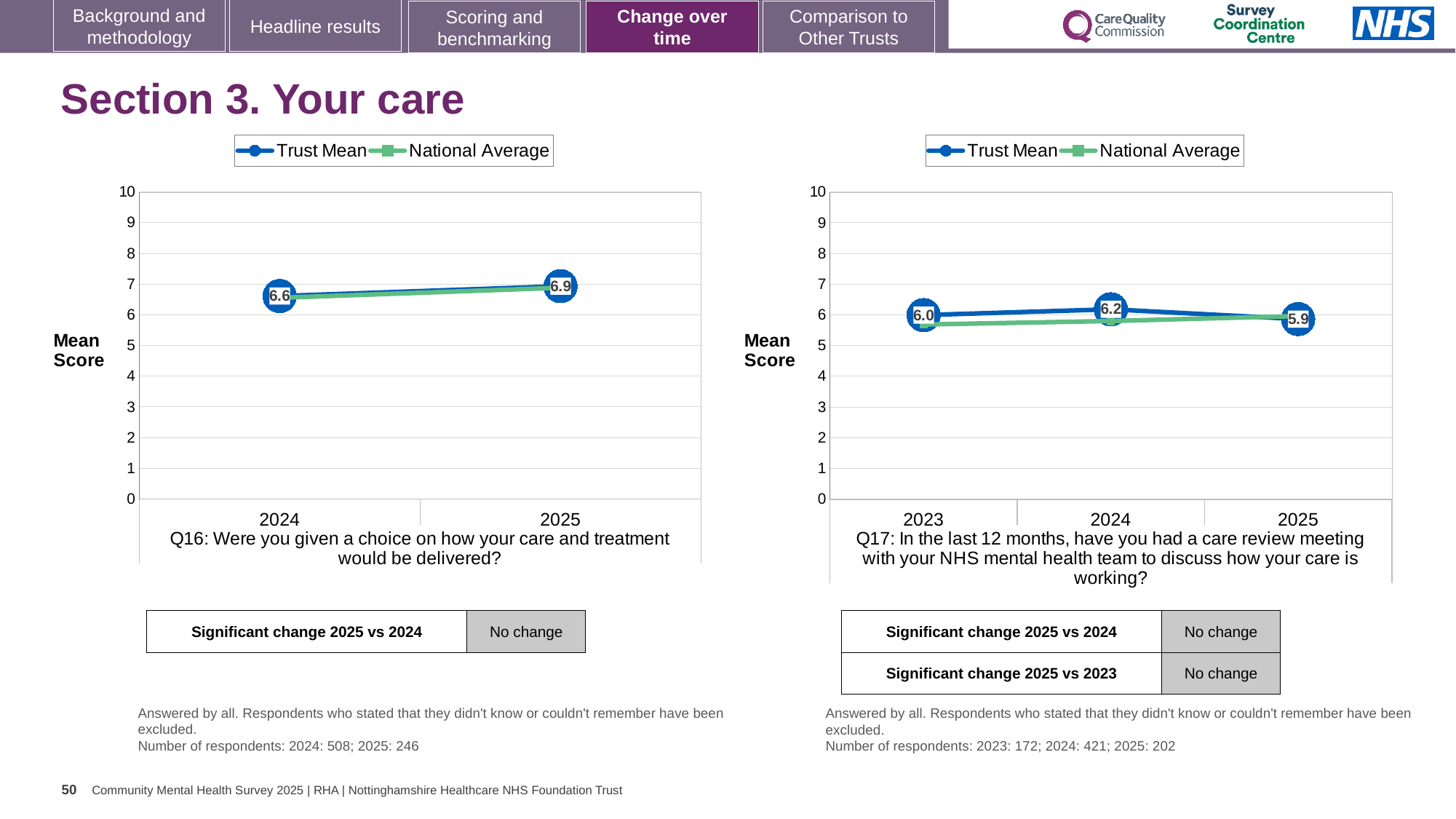
What type of chart is the Q17 chart (right)? line chart On the Q17 chart (right), which year has the highest Trust Mean? 2024 On the Q17 chart (right), what is the Trust Mean for 2023? 6.0 On the Q17 chart (right), what is the Trust Mean for 2024? 6.2 On the Q16 chart (left), what is the Trust Mean for 2024? 6.6 On the Q16 chart (left), how many series does the legend list? 2 On the Q17 chart (right), how many years are plotted on the x axis? 3 On the Q16 chart (left), what is the Trust Mean for 2025? 6.9 On the Q16 chart (left), by how much did the Trust Mean change from 2024 to 2025? 0.3 On the Q16 chart (left), does the Trust Mean rise or fall from 2024 to 2025? rise On the Q17 chart (right), which year has the lowest Trust Mean? 2025 On the Q17 chart (right), what is the Trust Mean for 2025? 5.9